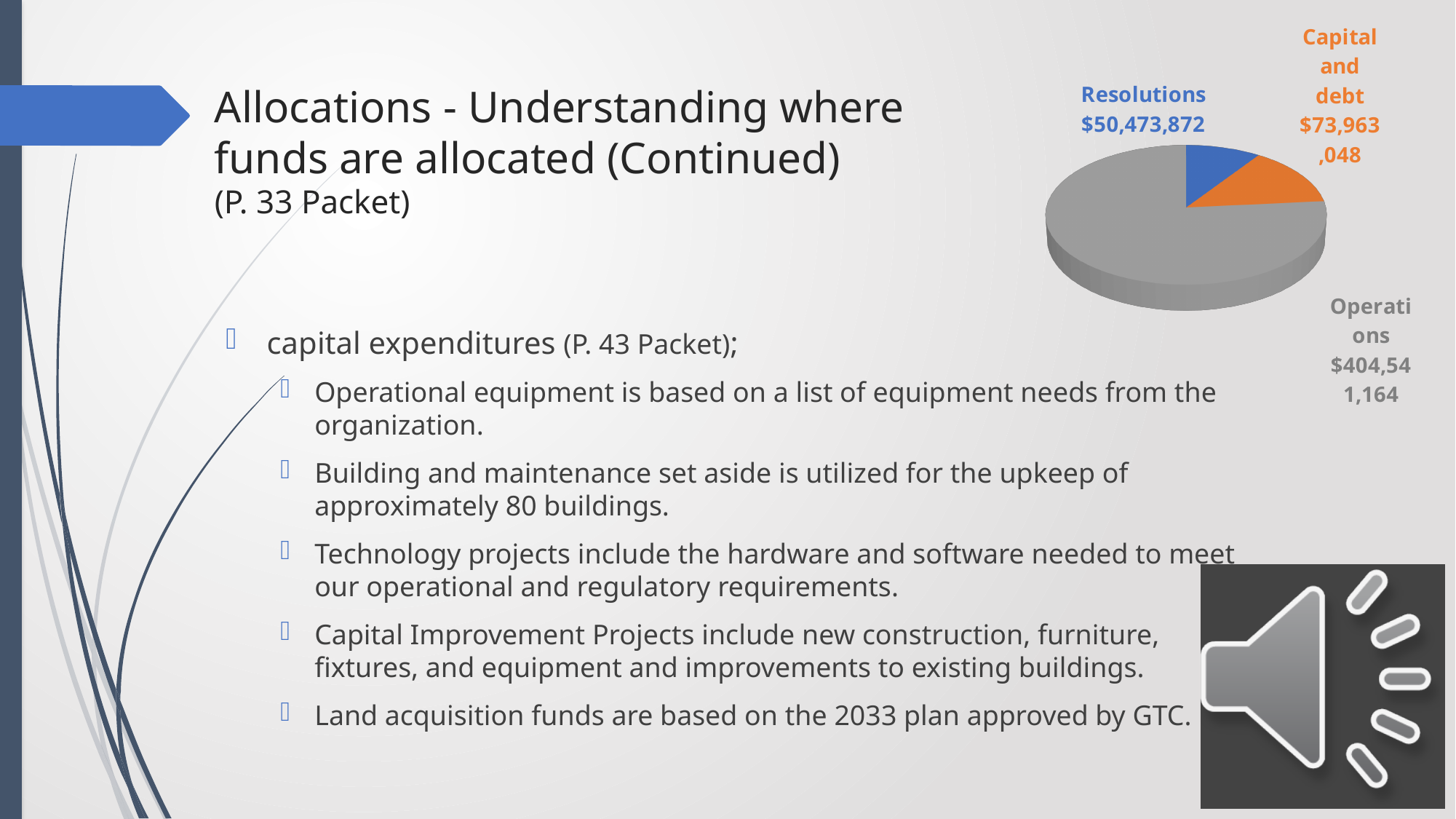
Which is larger in the pie chart, Resolutions or Capital and debt? Capital and debt What is the total of the three values shown in the pie chart? $528,978,084 What is the value shown for Capital and debt in the pie chart? $73,963,048 Which category has the largest slice in the pie chart? Operations What kind of chart is shown on the slide? pie chart What is the value shown for Resolutions in the pie chart? $50,473,872 Which category has the smallest slice in the pie chart? Resolutions What is the difference between the Capital and debt value and the Resolutions value in the pie chart? $23,489,176 What colour is the Operations slice in the pie chart? gray How many slices does the pie chart have? 3 What is the value shown for Operations in the pie chart? $404,541,164 What is the difference between the Operations value and the Capital and debt value in the pie chart? $330,578,116